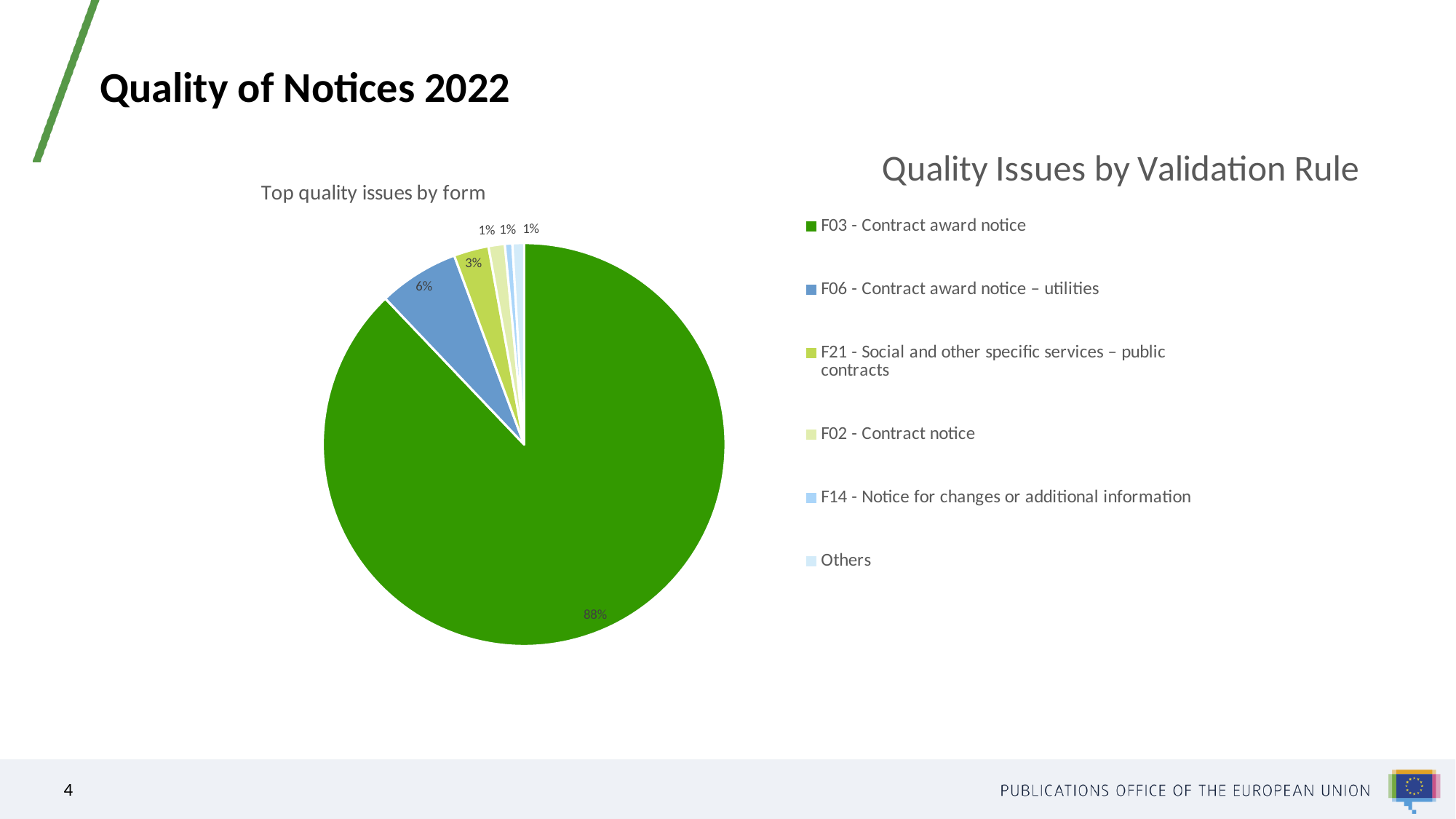
What share of the pie does F21 - Social and other specific services – public contracts have? 3% What is the combined share of F06 - Contract award notice – utilities and F21 - Social and other specific services – public contracts? 9% What kind of chart is shown on the slide? pie chart What colour is the slice for F03 - Contract award notice? green What share of the pie does F06 - Contract award notice – utilities have? 6% What is the difference between the shares of F03 - Contract award notice and F06 - Contract award notice – utilities? 82 percentage points What share of the pie does F03 - Contract award notice have? 88% Which category has the largest slice of the pie? F03 - Contract award notice Which is larger, the share for F06 - Contract award notice – utilities or the share for F21 - Social and other specific services – public contracts? F06 - Contract award notice – utilities How many categories does the legend list? 6 What is the title of the chart? Top quality issues by form